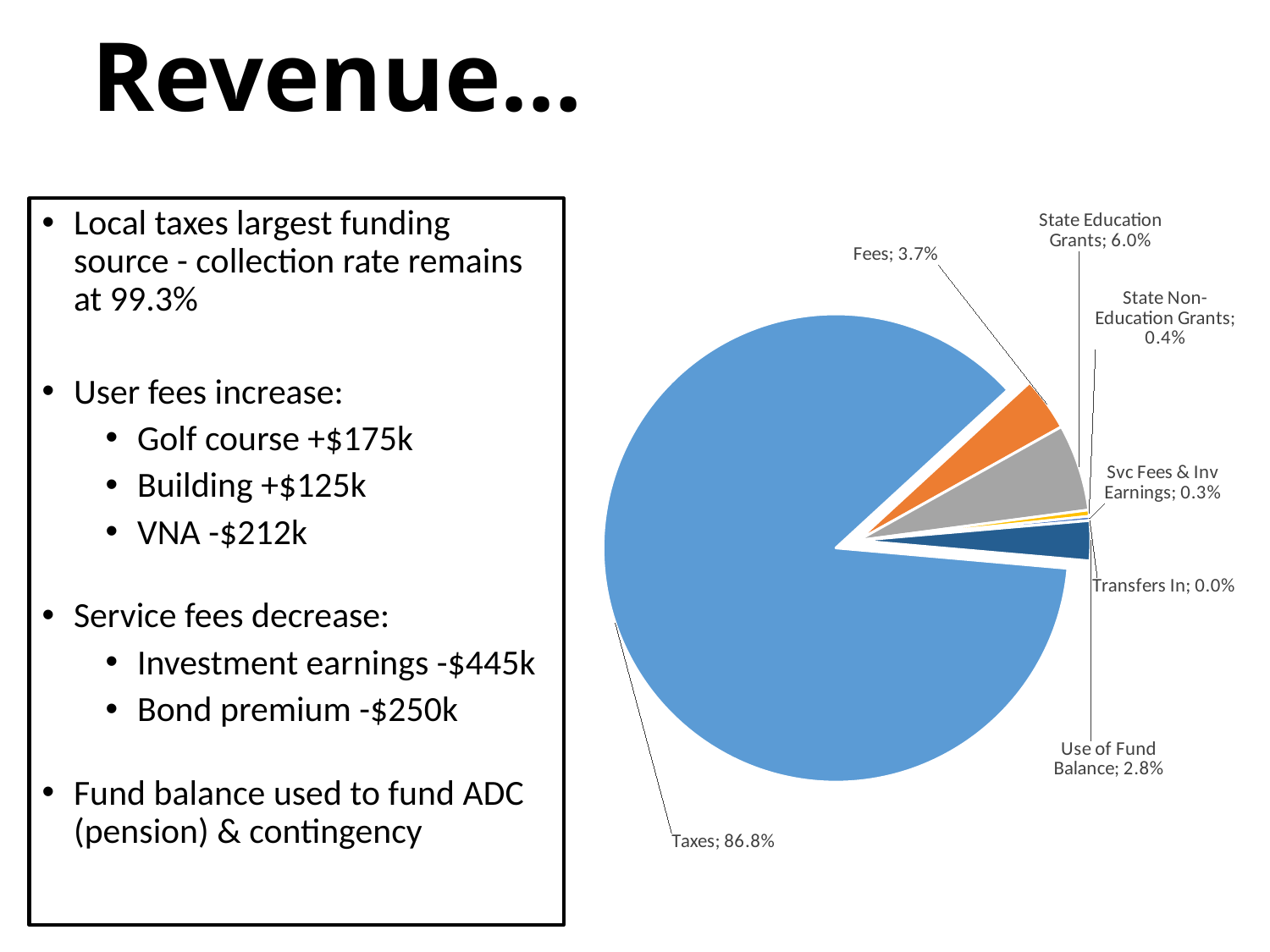
What is the difference between the Fees share and the Use of Fund Balance share? 0.9% Which category has the smallest slice of the pie? Transfers In Which category has the largest slice of the pie? Taxes Which is larger, State Education Grants or Fees? State Education Grants What is the difference between the Taxes share and the State Education Grants share? 80.8% How many categories are shown in the pie chart? 7 What kind of chart is shown on the slide? pie chart What is the value shown for Transfers In? 0.0% What share of the pie does Taxes represent? 86.8% What is the value shown for Use of Fund Balance? 2.8% What is the value shown for State Education Grants? 6.0% What is the value shown for Fees? 3.7%